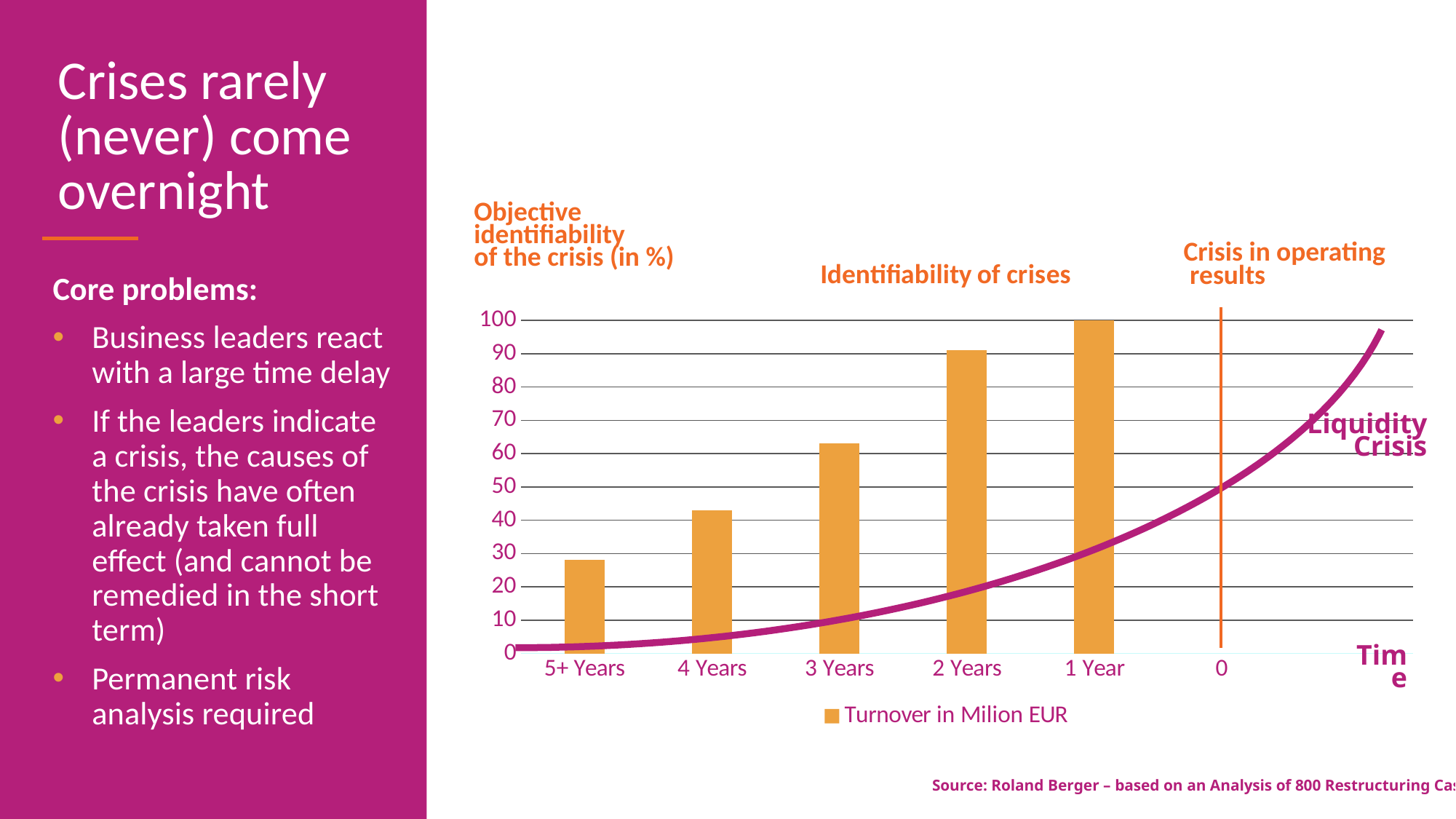
What is the value for 1 Year? 100 Is the value for 5+ Years greater or less than 30? less Which category has the lowest bar? 5+ Years What is the title of the chart? Identifiability of crises Which category has the highest bar? 1 Year Which is larger, the value for 2 Years or the value for 3 Years? 2 Years Is the value for 3 Years greater or less than 60? greater What kind of chart is shown on the slide? bar chart What series does the legend list? Turnover in Milion EUR How many bars are plotted in the chart? 5 How many series does the legend list? 1 Is the value for 4 Years greater or less than 40? greater